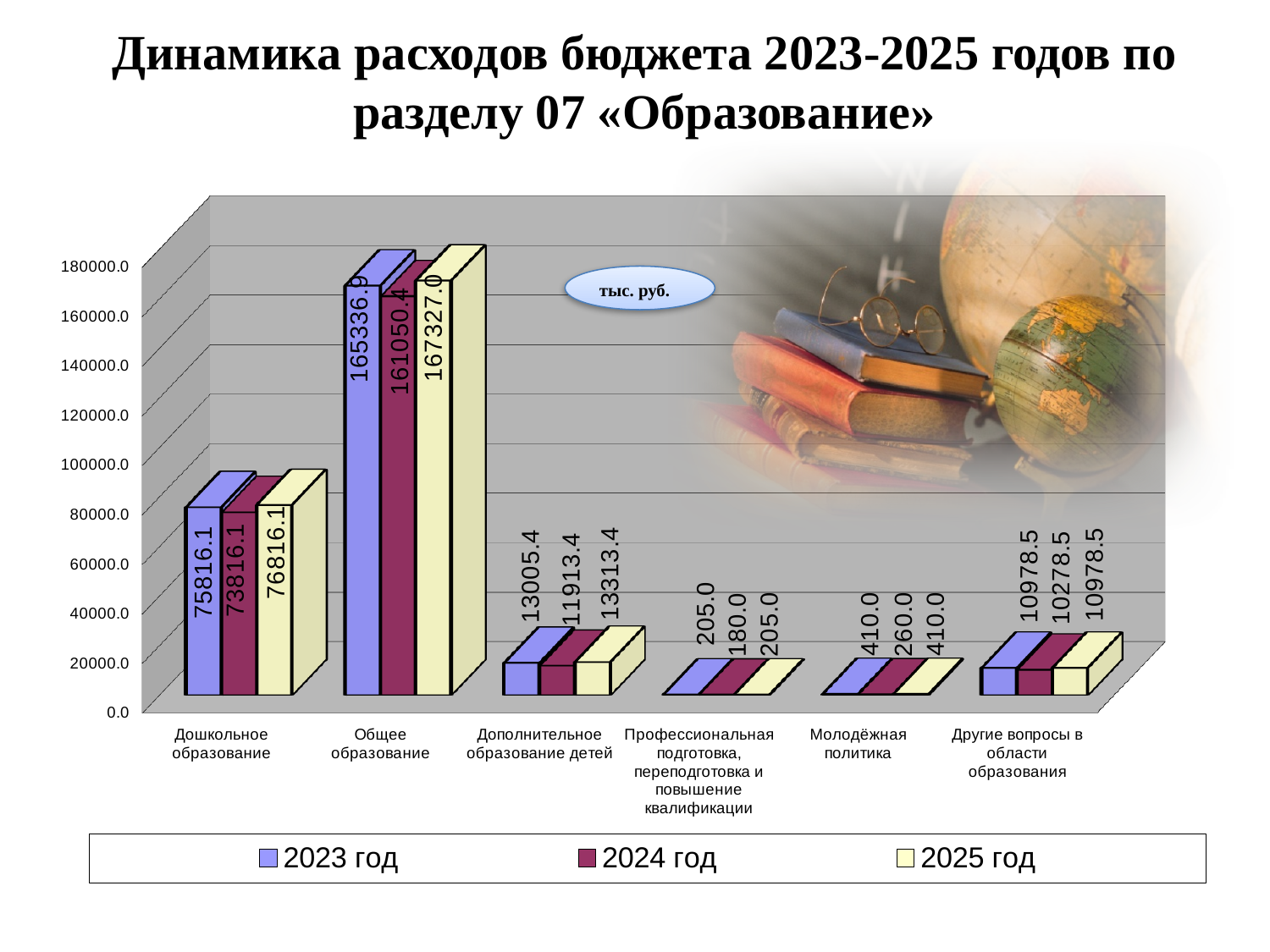
What is the value for Общее образование in the 2024 год series? 161050.4 Which category has the lowest value in the 2024 год series? Профессиональная подготовка, переподготовка и повышение квалификации What is the value for Другие вопросы в области образования in the 2024 год series? 10278.5 How many series does the legend list? 3 Which category has the highest value in the 2025 год series? Общее образование How many categories are shown on the x axis? 6 What unit of measurement is indicated on the chart? тыс. руб. What is the difference between the 2025 год and 2024 год values for Дошкольное образование? 3000.0 What is the value for Молодёжная политика in the 2025 год series? 410.0 What is the value for Дошкольное образование in the 2023 год series? 75816.1 Which is larger for Дополнительное образование детей: the 2023 год value or the 2025 год value? 2025 год What kind of chart is shown on the slide? Bar chart